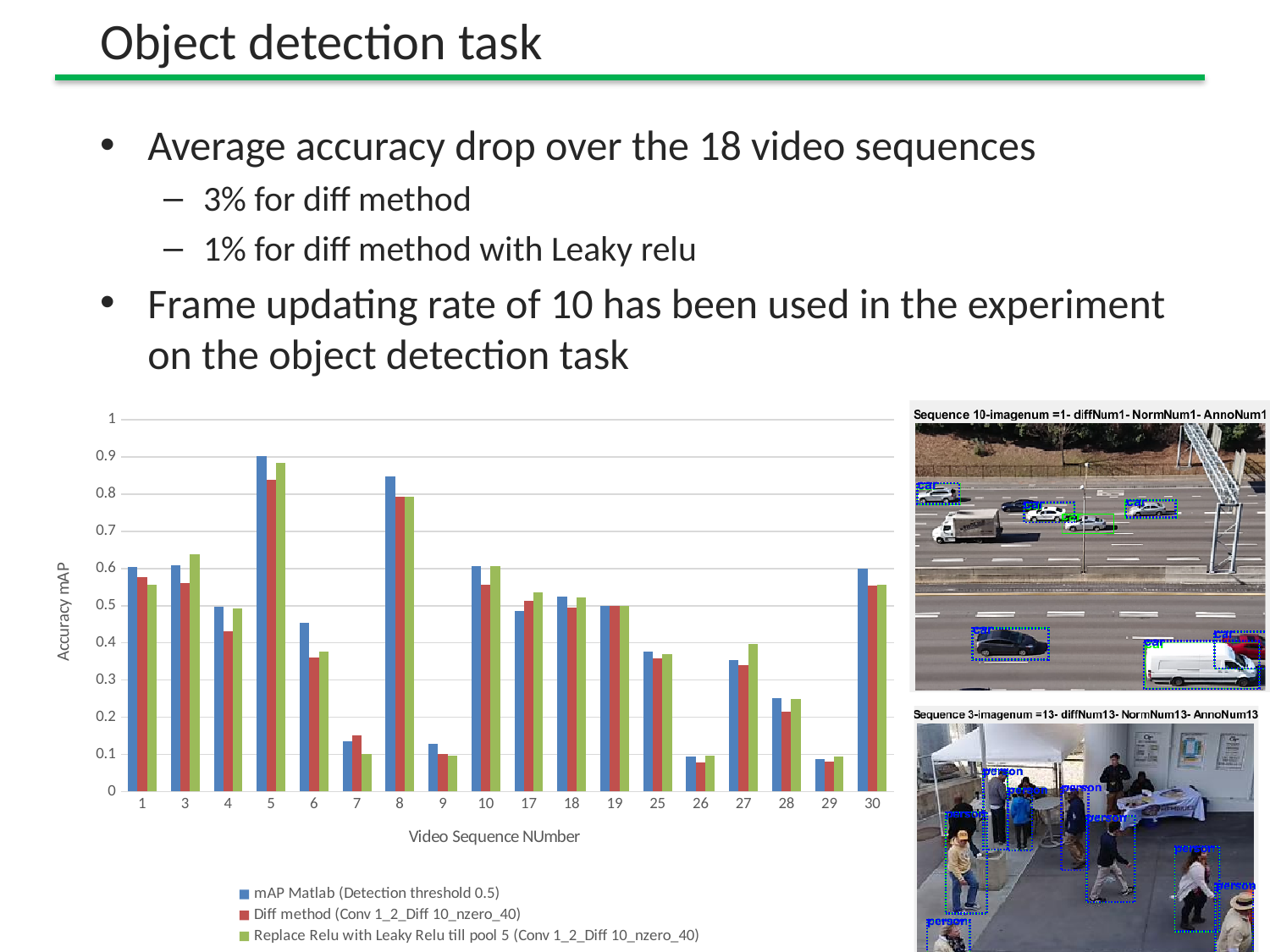
Is the mAP Matlab (Detection threshold 0.5) value for video sequence 8 greater or less than 0.8? greater For which video sequence number is the Replace Relu with Leaky Relu till pool 5 value highest? 5 Which is larger: the mAP Matlab (Detection threshold 0.5) value for video sequence 5 or for video sequence 8? video sequence 5 For which video sequence number is the mAP Matlab (Detection threshold 0.5) value highest? 5 For video sequence 6, which is larger: the mAP Matlab (Detection threshold 0.5) value or the Diff method value? mAP Matlab (Detection threshold 0.5) How many video sequence numbers are shown on the x axis of the chart? 18 Is the mAP Matlab (Detection threshold 0.5) value for video sequence 6 greater or less than 0.5? less Is the mAP Matlab (Detection threshold 0.5) value for video sequence 28 greater or less than 0.2? greater What is the title of the chart's x axis? Video Sequence NUmber What kind of chart is shown on the slide? bar chart What is the title of the chart's y axis? Accuracy mAP How many series does the chart's legend list? 3